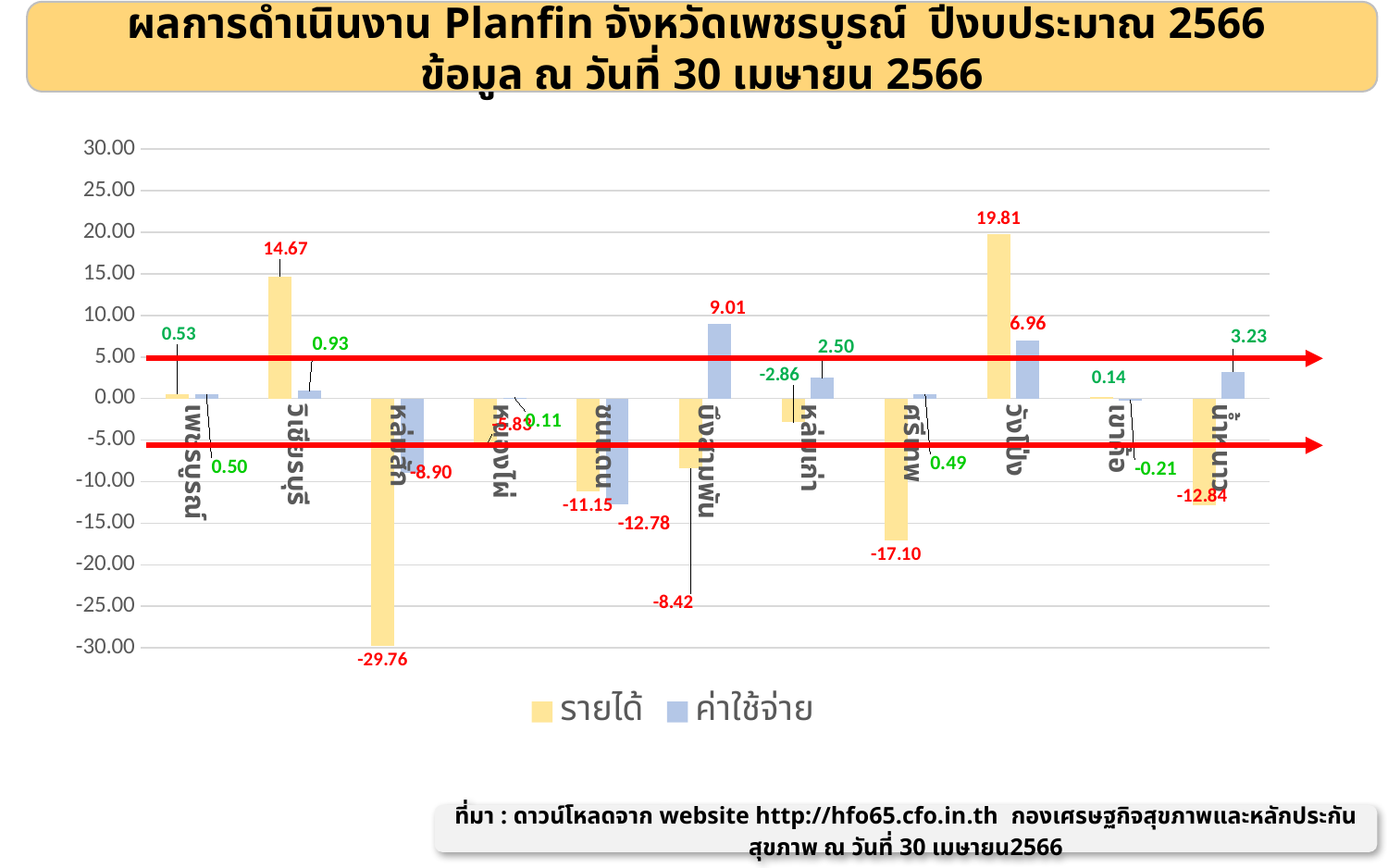
How many series does the legend list? 2 Which series is shown in yellow in the legend? รายได้ What is the รายได้ value for วังโป่ง? 19.81 What type of chart is shown on the slide? bar chart Which category has the lowest ค่าใช้จ่าย value? ชนแดน Which category has the lowest รายได้ value? หล่มสัก Which category has the highest รายได้ value? วังโป่ง How many categories (districts) are shown on the x axis? 11 Which is larger, the ค่าใช้จ่าย value for วังโป่ง or for หล่มเก่า? วังโป่ง What is the ค่าใช้จ่าย value for บึงสามพัน? 9.01 What is the รายได้ value for หล่มสัก? -29.76 What is the difference between the รายได้ values of วังโป่ง and วิเชียรบุรี? 5.14